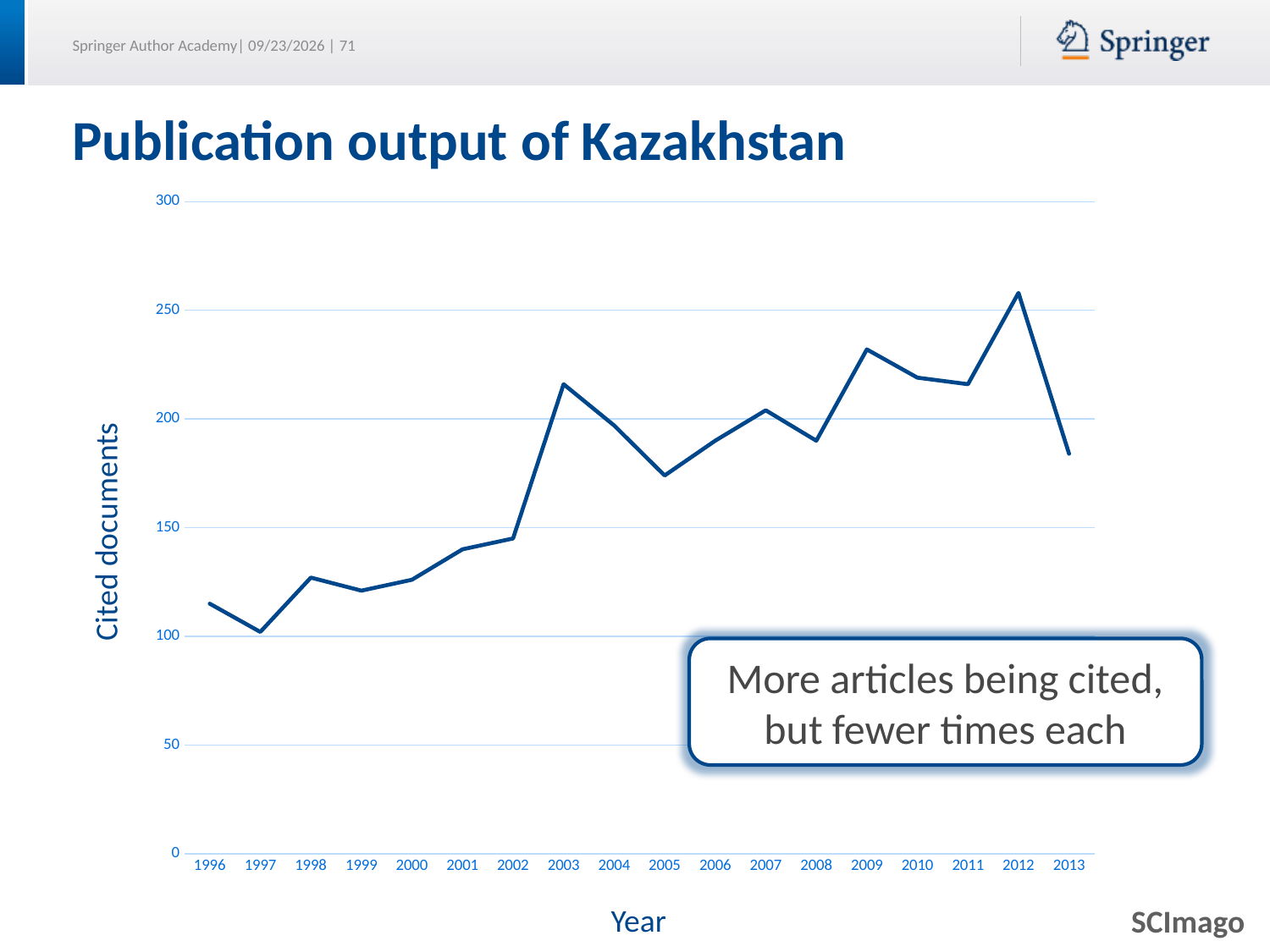
In which year is the number of cited documents lowest? 1997 What kind of chart is shown on the slide? line chart Is the value for 2001 greater or less than 150? less What is the title of the chart? Publication output of Kazakhstan What is the label of the vertical axis? Cited documents In which year is the number of cited documents highest? 2012 Is the value for 2003 greater or less than 200? greater Overall, do the values rise or fall from 1996 to 2013? rise How many years are plotted along the x axis? 18 Is the value for 2005 greater or less than 200? less Which year has more cited documents, 2009 or 2013? 2009